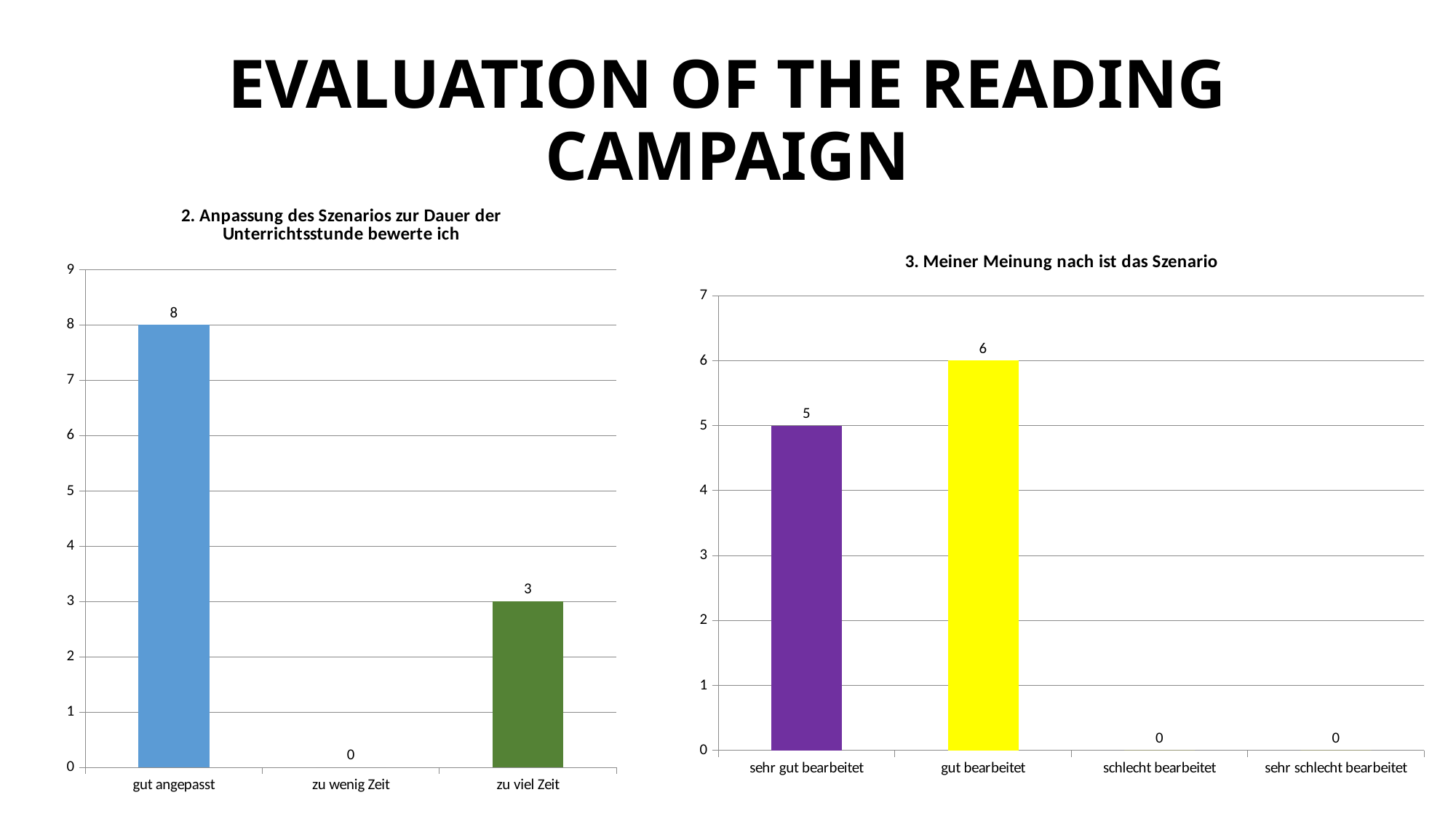
In the right chart ("3. Meiner Meinung nach ist das Szenario"), which category has the highest value? gut bearbeitet What kind of chart is the right chart ("3. Meiner Meinung nach ist das Szenario")? bar chart In the left chart ("2. Anpassung des Szenarios..."), how many categories are shown on the x axis? 3 In the right chart ("3. Meiner Meinung nach ist das Szenario"), what is the value for "schlecht bearbeitet"? 0 In the right chart ("3. Meiner Meinung nach ist das Szenario"), how many categories are shown on the x axis? 4 In the left chart ("2. Anpassung des Szenarios zur Dauer der Unterrichtsstunde bewerte ich"), what is the value for "gut angepasst"? 8 In the left chart ("2. Anpassung des Szenarios..."), what is the value for "zu viel Zeit"? 3 In the left chart ("2. Anpassung des Szenarios..."), what is the difference between the values for "gut angepasst" and "zu viel Zeit"? 5 In the left chart ("2. Anpassung des Szenarios..."), which category has the lowest value? zu wenig Zeit In the right chart ("3. Meiner Meinung nach ist das Szenario"), what colour is the bar for "gut bearbeitet"? yellow In the right chart ("3. Meiner Meinung nach ist das Szenario"), what is the value for "sehr gut bearbeitet"? 5 In the right chart ("3. Meiner Meinung nach ist das Szenario"), what is the value for "gut bearbeitet"? 6